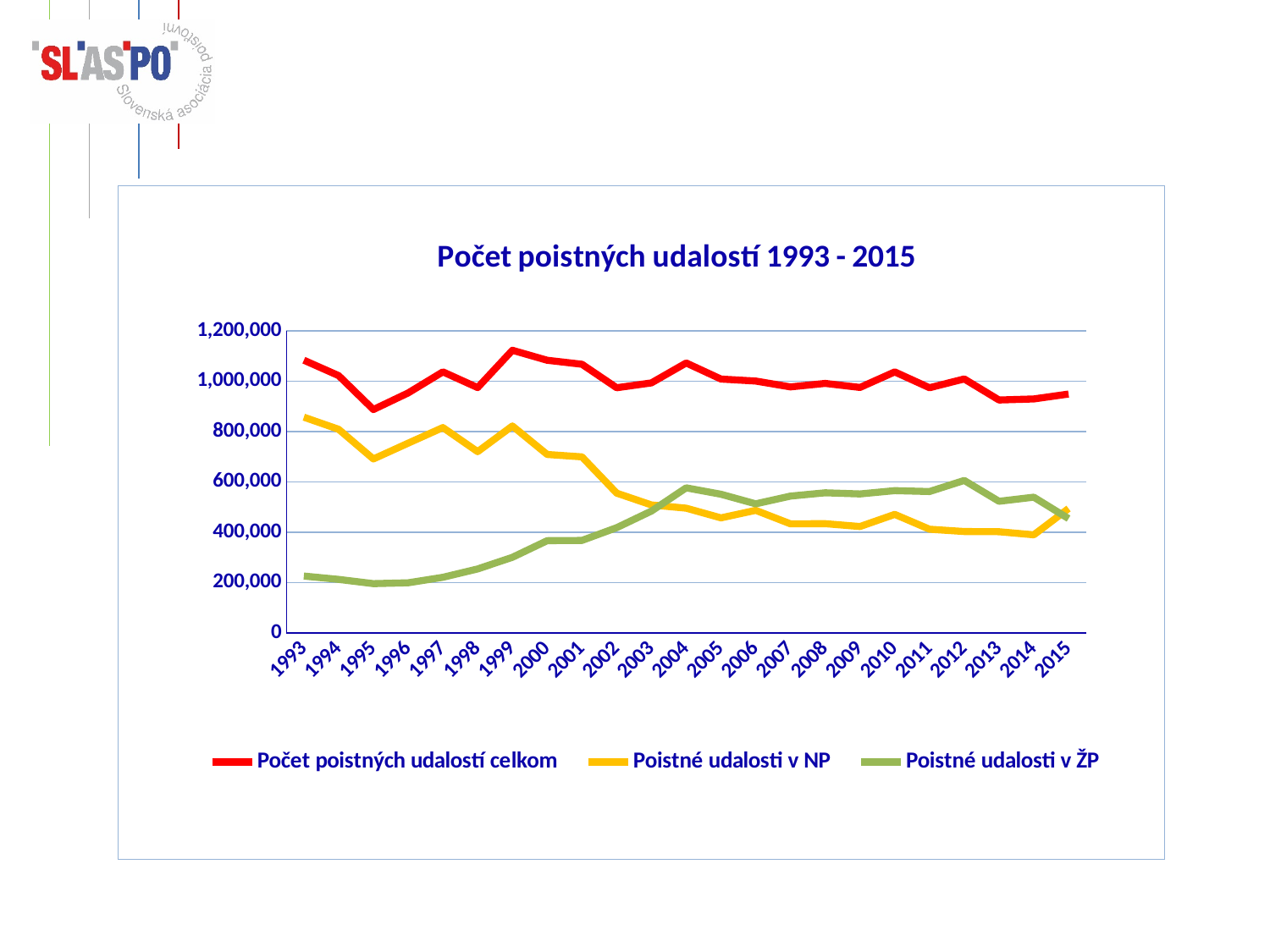
Which colour is used for the series 'Poistné udalosti v ŽP'? green How many years are plotted along the x axis? 23 Is the value of 'Počet poistných udalostí celkom' in 1995 greater or less than 1,000,000? less What is the title of the chart? Počet poistných udalostí 1993 - 2015 What kind of chart is shown on the slide? line chart In which year is 'Poistné udalosti v NP' at its highest? 1993 Is the value of 'Poistné udalosti v NP' in 1993 greater or less than 800,000? greater Is the value of 'Poistné udalosti v ŽP' in 1993 greater or less than 400,000? less In 2001, which series has the larger value: 'Poistné udalosti v NP' or 'Poistné udalosti v ŽP'? Poistné udalosti v NP How many series does the legend list? 3 In which year is 'Poistné udalosti v ŽP' at its highest? 2012